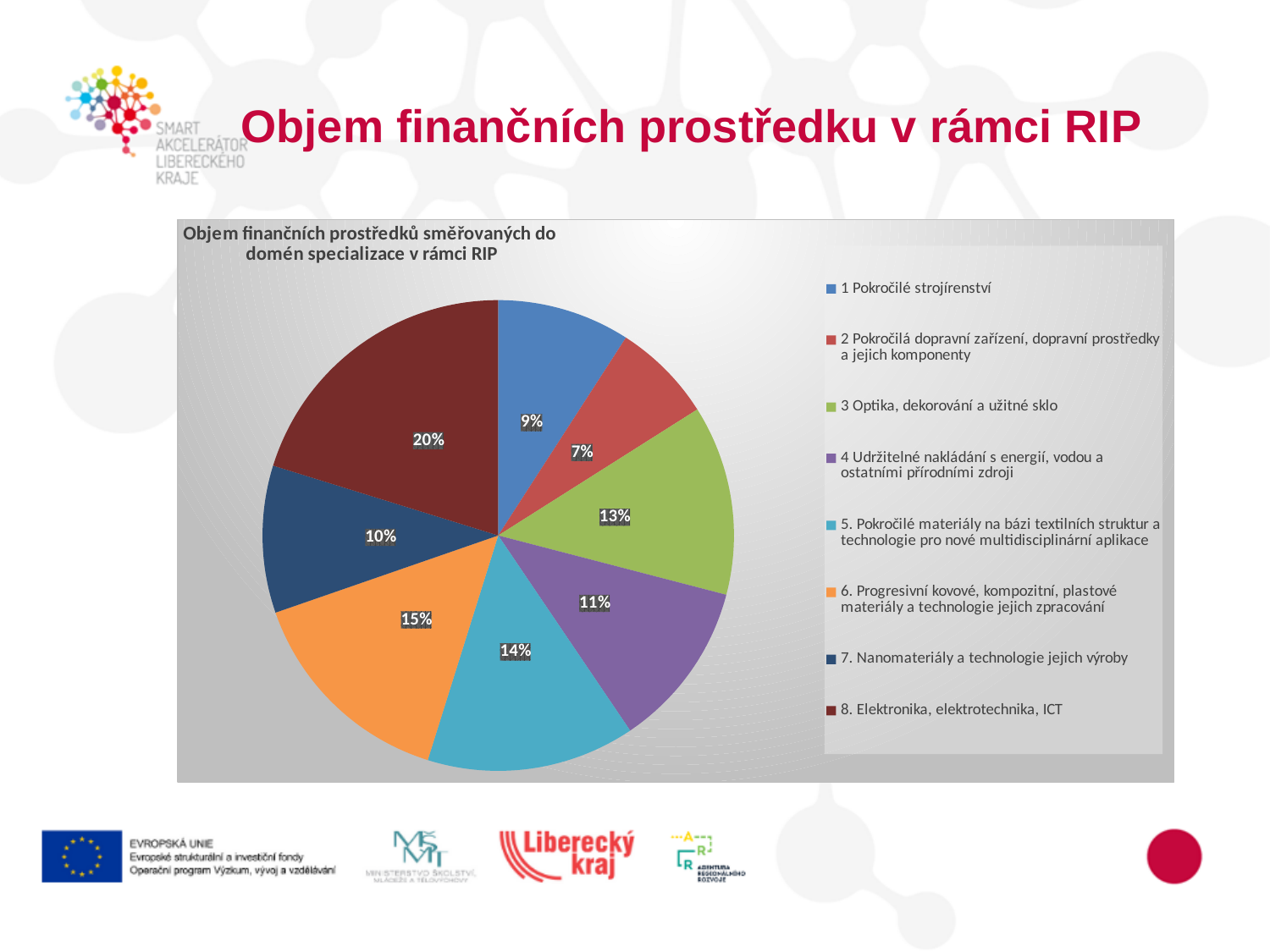
What colour is the slice for "3 Optika, dekorování a užitné sklo"? green What share of the pie does "7. Nanomateriály a technologie jejich výroby" have? 10% How many slices does the pie chart have? 8 Which category has the largest slice of the pie? 8. Elektronika, elektrotechnika, ICT What share of the pie does "8. Elektronika, elektrotechnika, ICT" have? 20% Which slice is larger: "6. Progresivní kovové, kompozitní, plastové materiály a technologie jejich zpracování" or "5. Pokročilé materiály na bázi textilních struktur a technologie pro nové multidisciplinární aplikace"? 6. Progresivní kovové, kompozitní, plastové materiály a technologie jejich zpracování What kind of chart is shown on the slide? pie chart What is the title of the pie chart? Objem finančních prostředků směřovaných do domén specializace v rámci RIP Which category has the smallest slice of the pie? 2 Pokročilá dopravní zařízení, dopravní prostředky a jejich komponenty What share of the pie does "3 Optika, dekorování a užitné sklo" have? 13% What is the difference in percentage points between the slice for "8. Elektronika, elektrotechnika, ICT" and the slice for "2 Pokročilá dopravní zařízení, dopravní prostředky a jejich komponenty"? 13